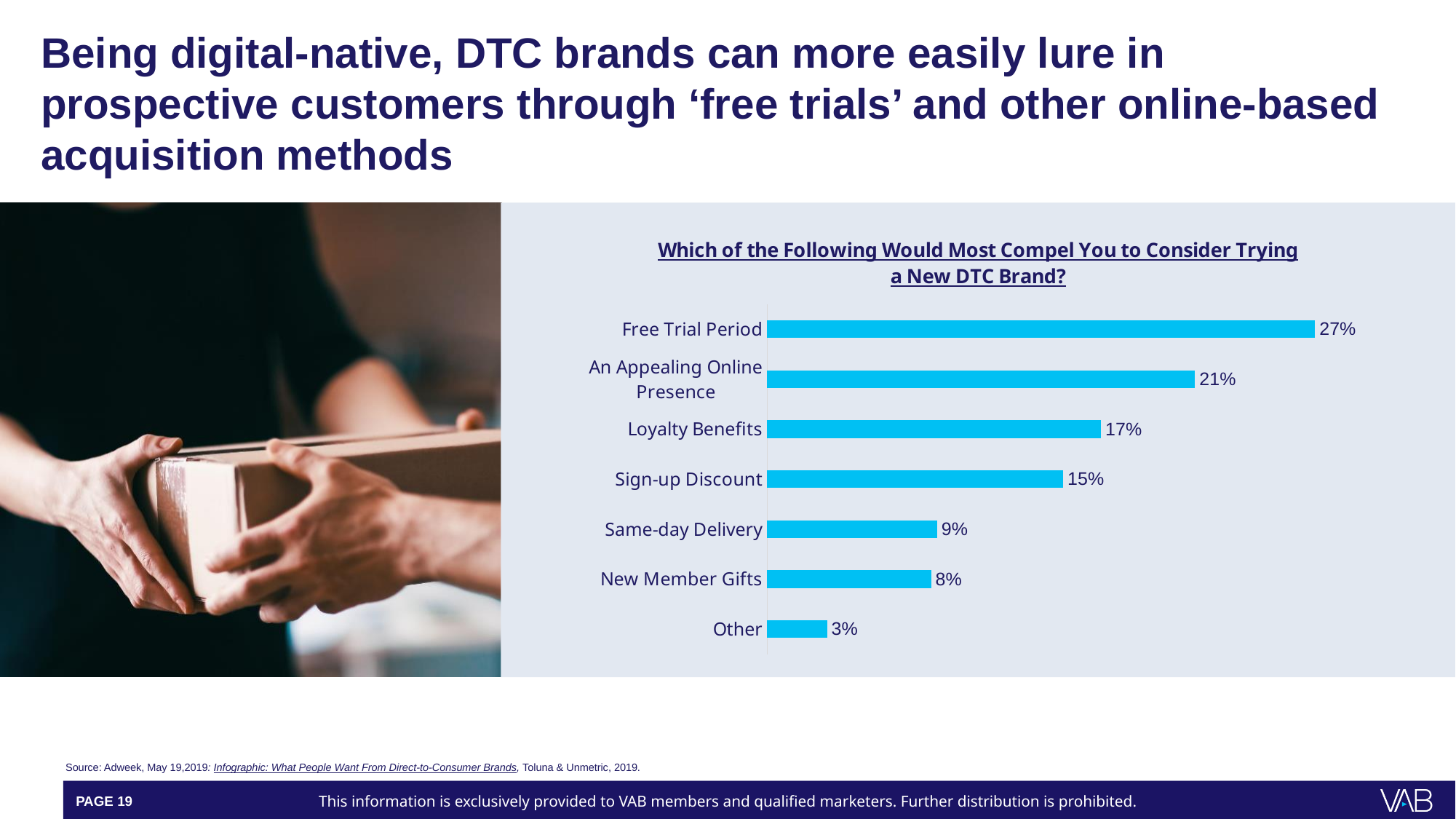
What is the title of the chart? Which of the Following Would Most Compel You to Consider Trying a New DTC Brand? What kind of chart is shown on the slide? Bar chart Which category has the highest value in the chart? Free Trial Period Which has a larger value, Loyalty Benefits or Sign-up Discount? Loyalty Benefits What is the difference between the values for Sign-up Discount and New Member Gifts? 7% What percentage of respondents chose Free Trial Period as what would most compel them to try a new DTC brand? 27% What is the value shown for Loyalty Benefits? 17% Which category has the lowest value in the chart? Other What is the difference between the values for Free Trial Period and An Appealing Online Presence? 6% How many categories are shown in the chart? 7 What is the value shown for Same-day Delivery? 9% Which has a larger value, Same-day Delivery or New Member Gifts? Same-day Delivery